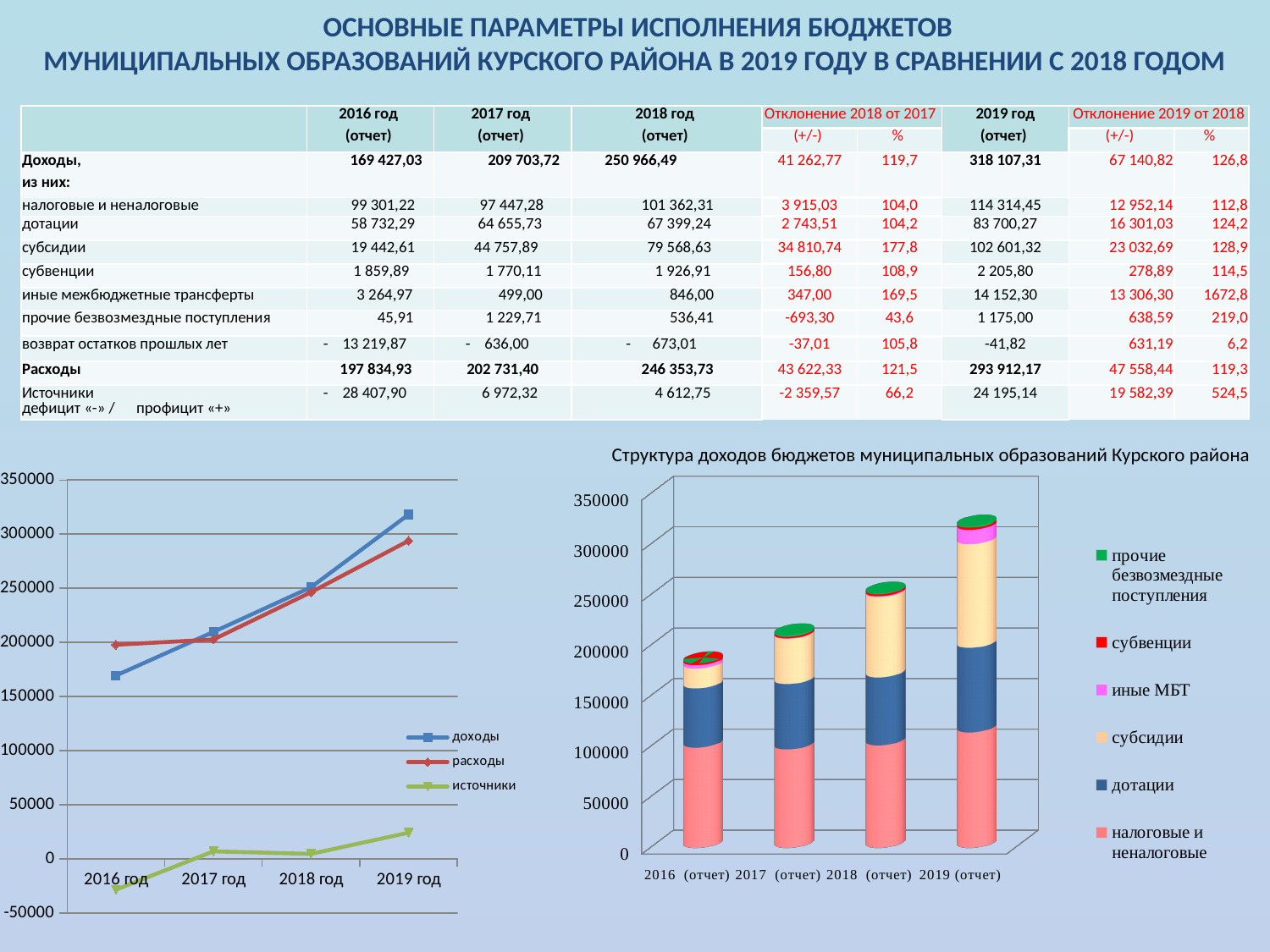
What kind of chart is the chart titled 'Структура доходов бюджетов муниципальных образований Курского района'? bar chart What kind of chart is the chart on the left of the slide? line chart How many years are shown on the x axis of the left line chart? 4 In the left line chart, which is larger in 2016 год: 'доходы' or 'расходы'? расходы In the chart 'Структура доходов бюджетов муниципальных образований Курского района', which year has the tallest stacked bar? 2019 (отчет) In the chart 'Структура доходов бюджетов муниципальных образований Курского района', is the total of the 2016 (отчет) bar greater or less than 200000? less In the left line chart, do the values for 'доходы' rise or fall from 2016 год to 2019 год? rise How many series does the legend of the chart 'Структура доходов бюджетов муниципальных образований Курского района' list? 6 In the left line chart, is the value for 'источники' in 2016 год greater or less than 0? less In the chart 'Структура доходов бюджетов муниципальных образований Курского района', which series is shown in dark blue? дотации In the left line chart, is the value for 'доходы' in 2019 год greater or less than 300000? greater How many series does the legend of the left line chart list? 3